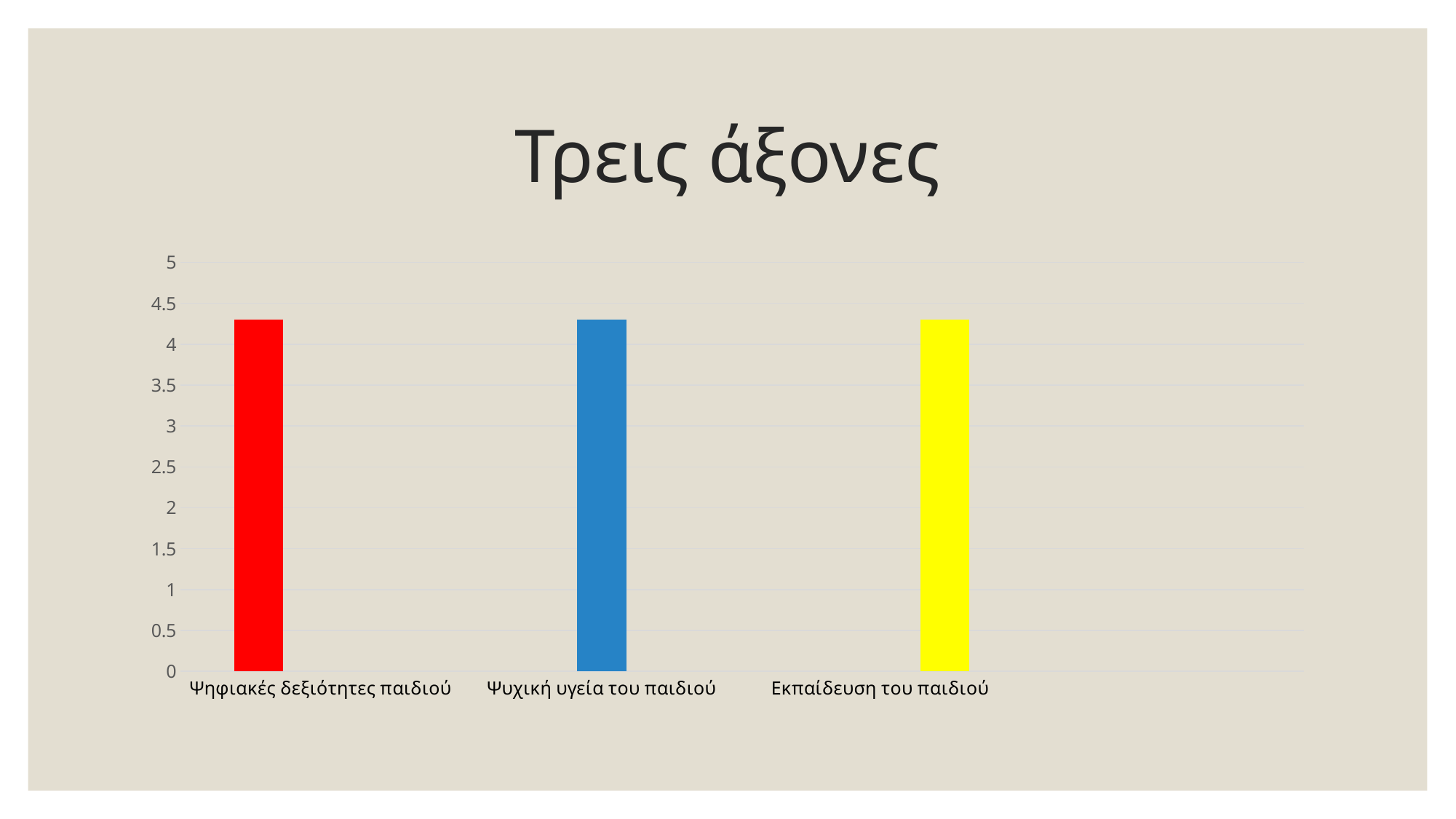
What kind of chart is shown on the slide? bar chart What is the highest value shown on the vertical axis? 5 Is the value for Ψυχική υγεία του παιδιού greater or less than 4.5? less How many categories are plotted in the chart? 3 Is the value for Εκπαίδευση του παιδιού greater or less than 4? greater Is the value for Εκπαίδευση του παιδιού greater or less than 3? greater What colour is the bar for Ψυχική υγεία του παιδιού? blue What is the title of the slide containing the chart? Τρεις άξονες